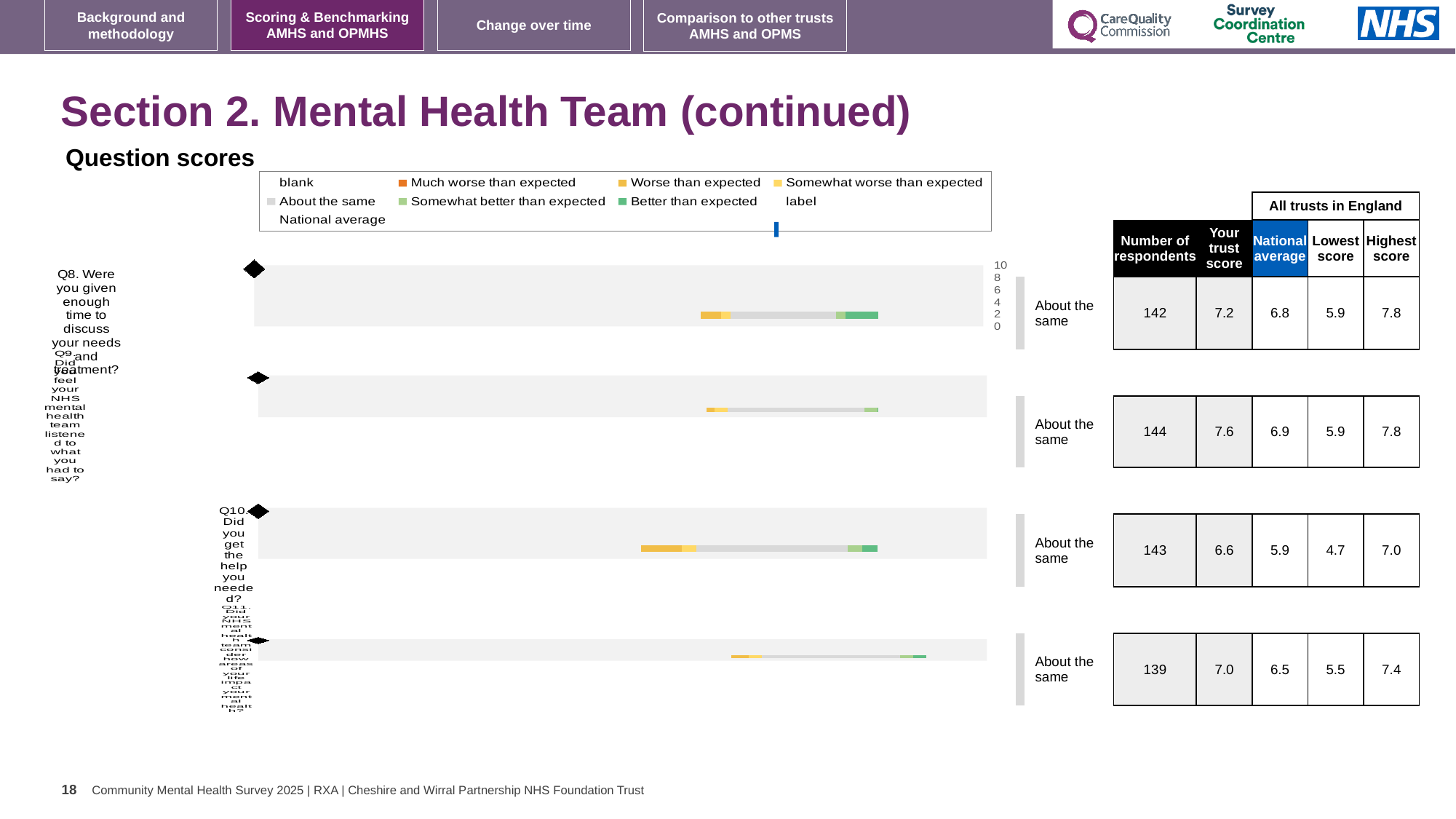
How many questions (bars) are plotted in the question scores chart? 4 What is the difference between the trust score and the national average for Q9? 0.7 What is the national average score for Q10 (Did you get the help you needed?)? 5.9 What is the difference between the highest and lowest scores for Q10? 2.3 What is the number of respondents for Q8 (Were you given enough time to discuss your needs and treatment?)? 142 What is the trust's score for Q9 (Did you feel your NHS mental health team listened to what you had to say?)? 7.6 What kind of chart is used to show the question scores on this slide? bar chart What benchmark category is shown next to each of the four question bars? About the same Which question has the lowest trust score? Q10 For Q8, which is larger: the trust score or the national average? the trust score What is the highest score among all trusts in England for Q11? 7.4 Which question has the highest trust score? Q9